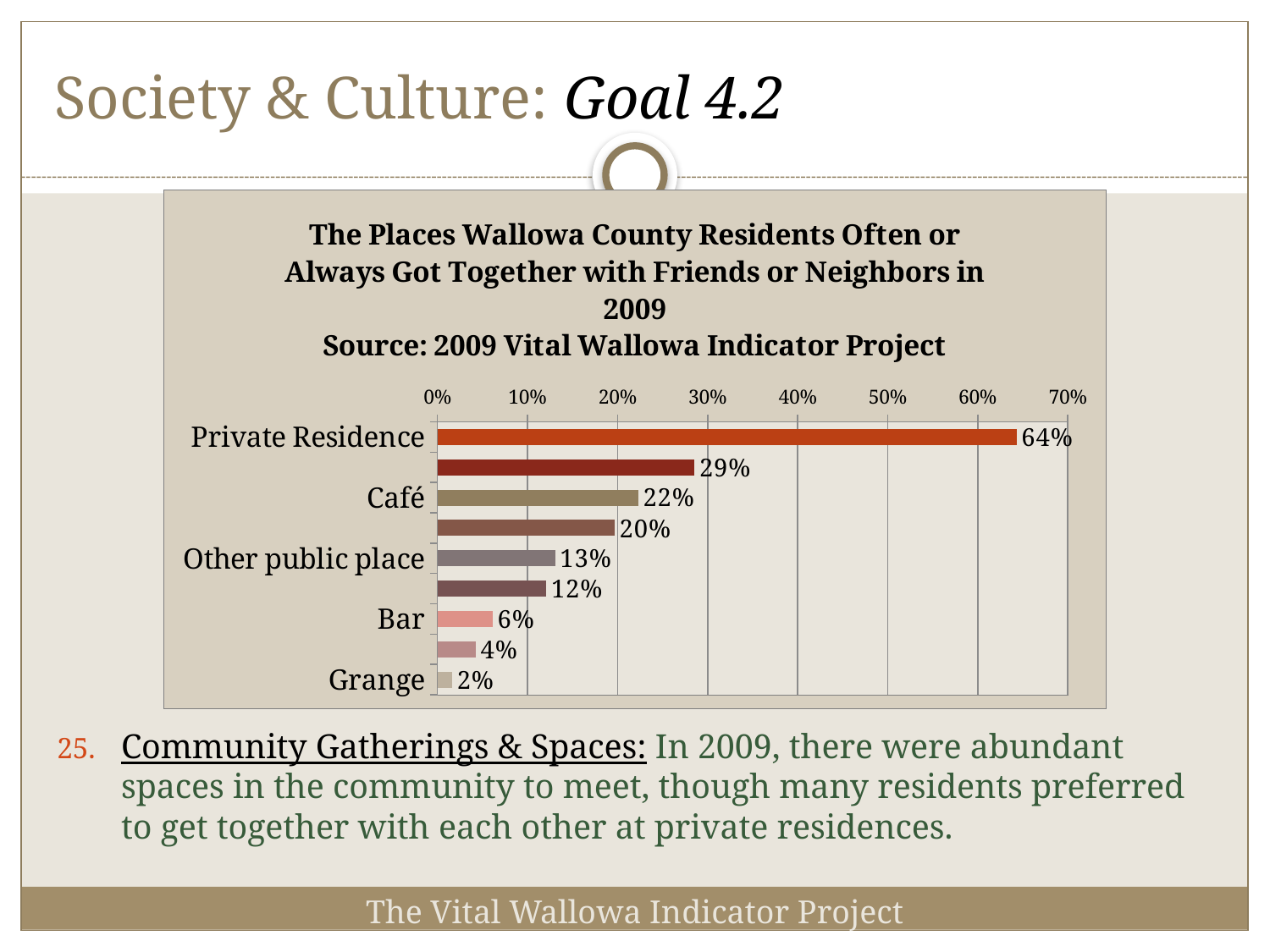
What is the value shown for Café? 22% Is the value for Private Residence greater or less than 60%? greater What is the value shown for Grange? 2% What is the difference between the values for Private Residence and Café? 42% What percentage of residents often or always got together at a Private Residence? 64% What is the value shown for Other public place? 13% What is the value shown for Bar? 6% How many bars are plotted in the chart? 9 Which place has the highest percentage? Private Residence Which is larger, the value for Bar or the value for Other public place? Other public place Which place has the lowest percentage? Grange What kind of chart is shown on the slide? Bar chart